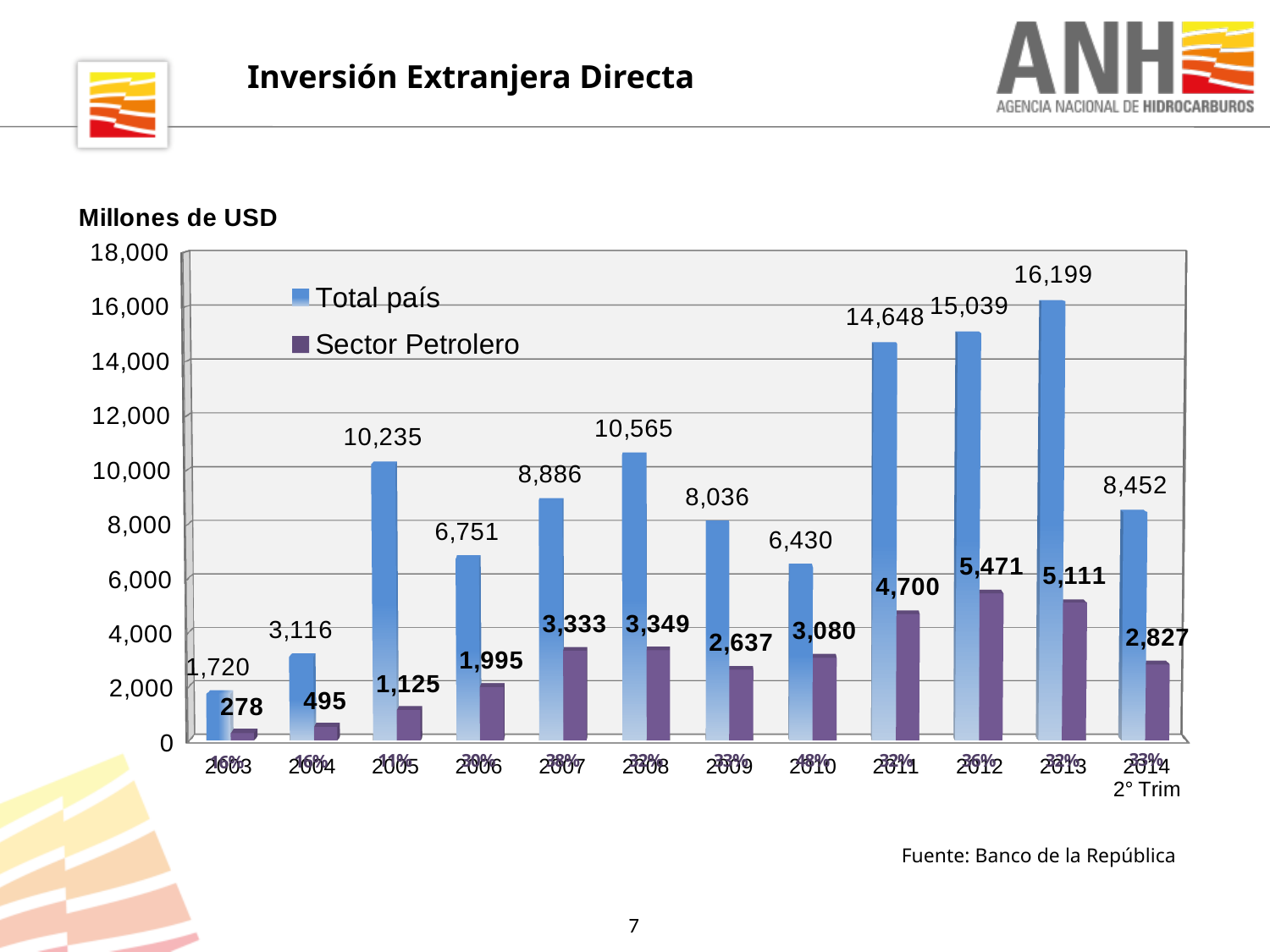
How many year categories are shown on the x axis? 12 Which year has the lowest Sector Petrolero value? 2003 Which year has the highest Total país value? 2013 What unit is stated above the chart? Millones de USD What kind of chart is shown on the slide? Bar chart What is the value of Sector Petrolero for 2012? 5,471 What is the value of Total país for 2013? 16,199 What is the difference between Total país and Sector Petrolero in 2011? 9,948 How many series does the legend list? 2 Which is larger, the Total país value for 2008 or for 2009? 2008 What is the value of Sector Petrolero for 2003? 278 What is the value of Total país for 2005? 10,235